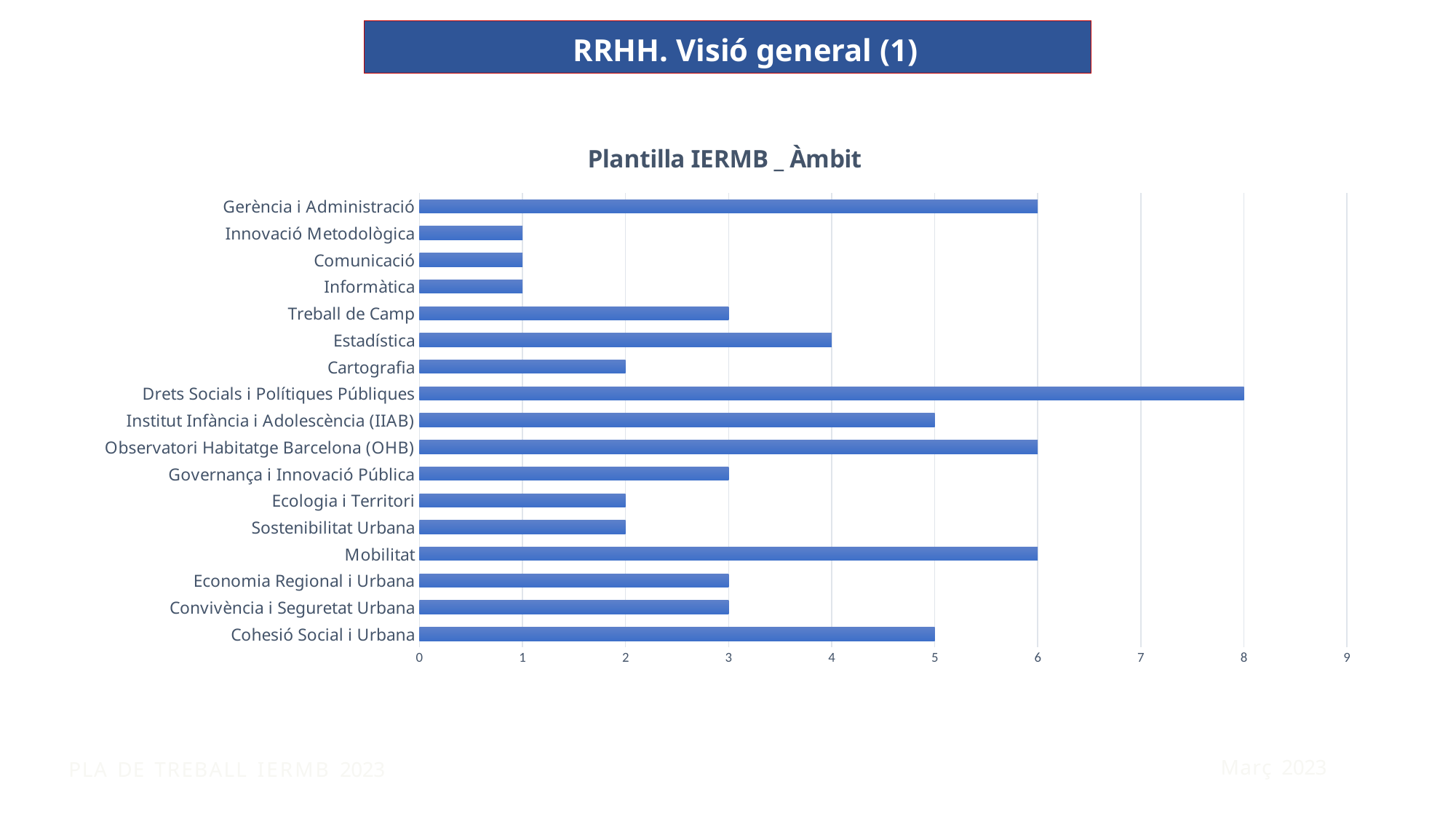
Which category has the highest value? Drets Socials i Polítiques Públiques What is the value for Estadística? 4 Which is larger, the value for Treball de Camp or the value for Cartografia? Treball de Camp How many categories are plotted in the chart? 17 What is the value for Drets Socials i Polítiques Públiques? 8 What is the value for Cohesió Social i Urbana? 5 What is the difference between the values for Drets Socials i Polítiques Públiques and Gerència i Administració? 2 What is the value for Mobilitat? 6 What type of chart is shown on the slide? Bar chart What is the title of the chart? Plantilla IERMB _ Àmbit Is the value for Institut Infància i Adolescència (IIAB) greater or less than 4? greater What is the value for Informàtica? 1